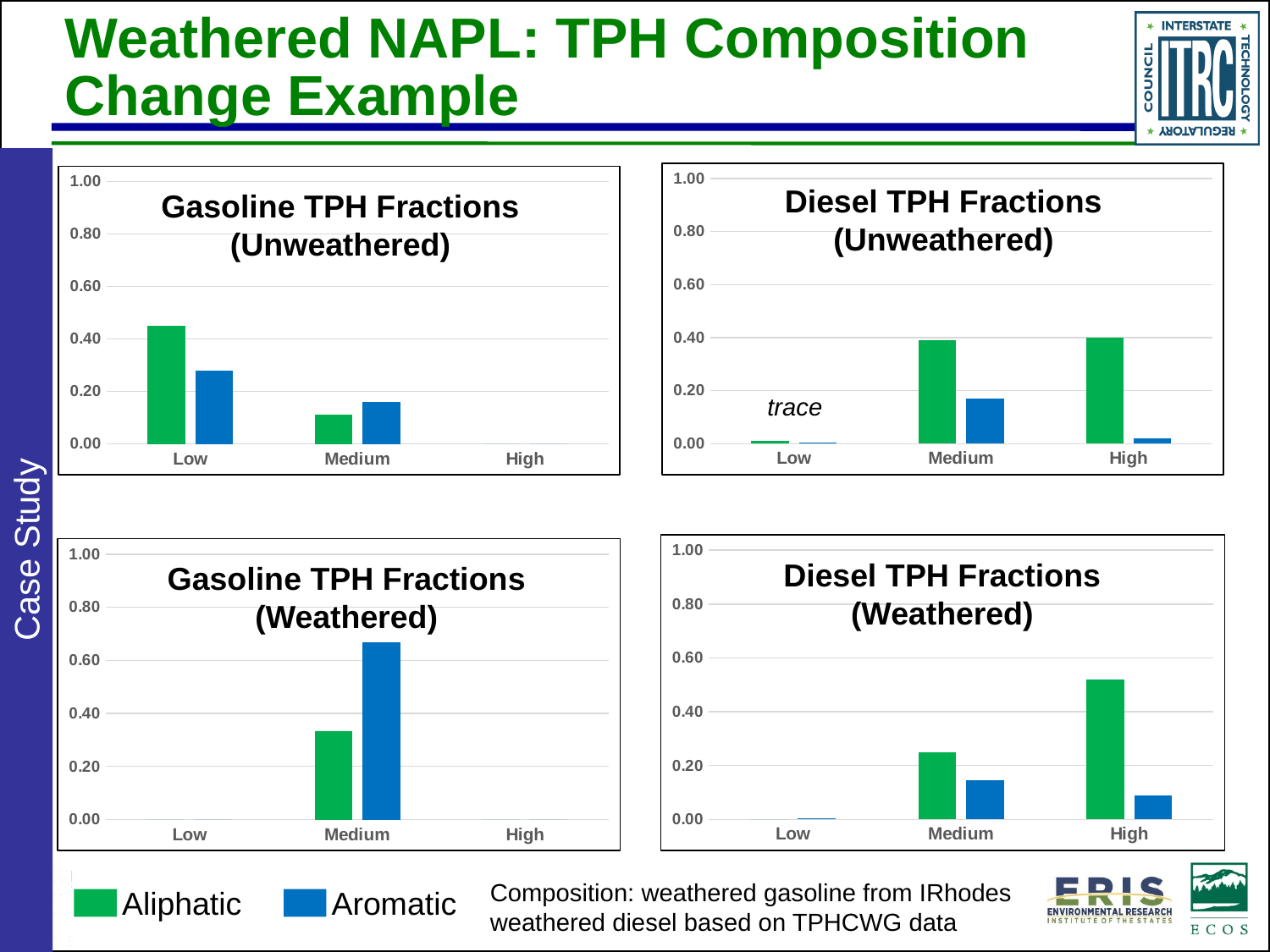
How many categories are shown on the x axis of the "Diesel TPH Fractions (Weathered)" chart? 3 In the "Diesel TPH Fractions (Weathered)" chart, is the Aliphatic value for High greater or less than 0.40? greater How many series does the legend at the bottom of the slide list? 2 In the "Diesel TPH Fractions (Weathered)" chart, do the Aliphatic values rise or fall from Low to High? rise What word is written above the Low category in the "Diesel TPH Fractions (Unweathered)" chart? trace In the "Gasoline TPH Fractions (Unweathered)" chart, is the Aliphatic value for Low greater or less than 0.40? greater In the "Gasoline TPH Fractions (Weathered)" chart, which is larger for Medium, the Aliphatic or the Aromatic value? Aromatic In the "Diesel TPH Fractions (Weathered)" chart, which category has the lowest Aliphatic value? Low In the "Gasoline TPH Fractions (Weathered)" chart, is the Aromatic value for Medium greater or less than 0.60? greater What kind of chart is the "Gasoline TPH Fractions (Unweathered)" chart? bar chart In the "Gasoline TPH Fractions (Unweathered)" chart, which category has the highest Aliphatic value? Low